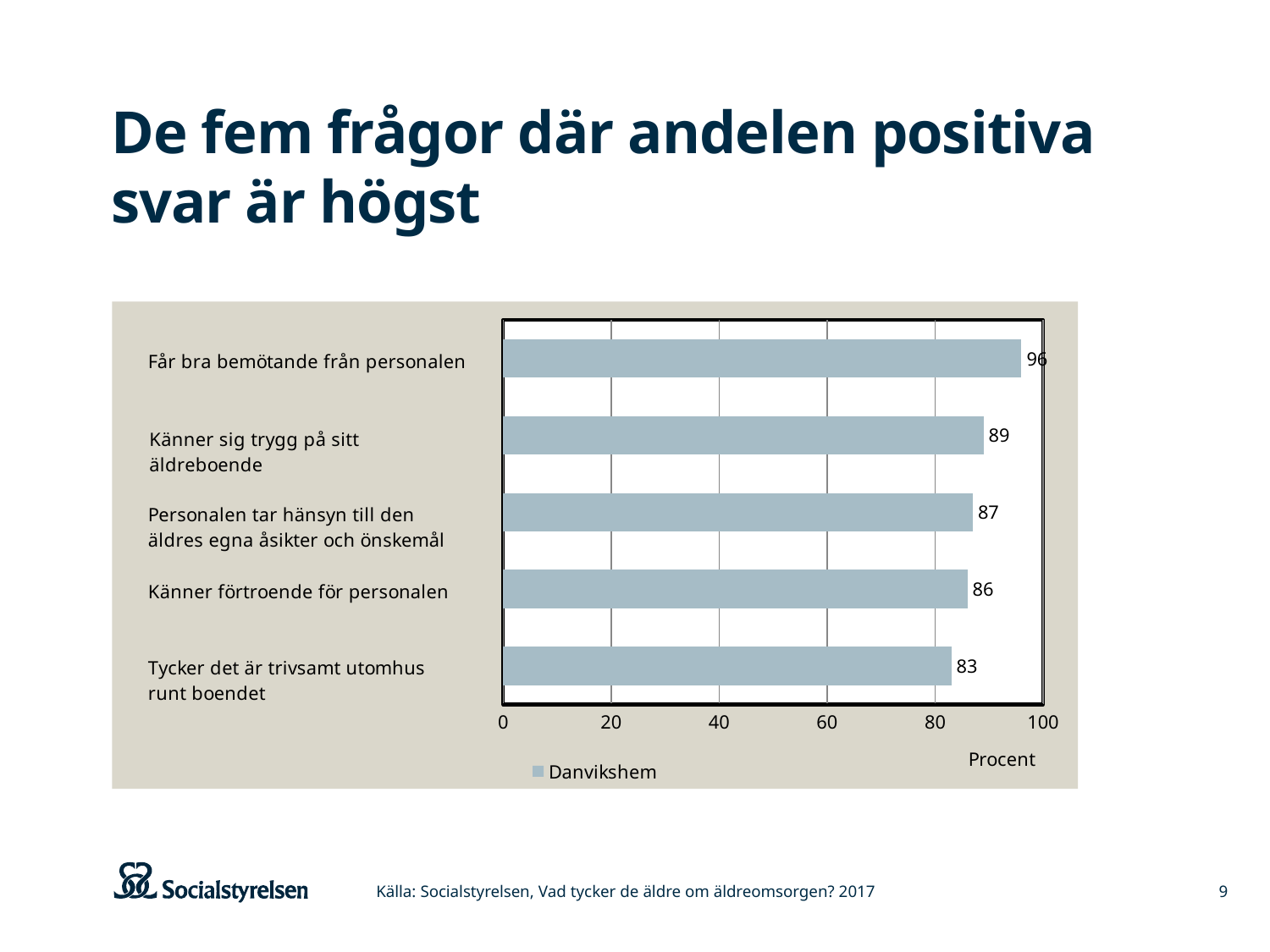
What kind of chart is shown on the slide? bar chart What is the value for "Känner förtroende för personalen"? 86 What is the value for "Får bra bemötande från personalen"? 96 What series name does the legend show? Danvikshem What is the value for "Känner sig trygg på sitt äldreboende"? 89 Is the value for "Känner sig trygg på sitt äldreboende" greater or less than 80? greater Which is larger: the value for "Personalen tar hänsyn till den äldres egna åsikter och önskemål" or the value for "Känner förtroende för personalen"? Personalen tar hänsyn till den äldres egna åsikter och önskemål Which category has the lowest value? Tycker det är trivsamt utomhus runt boendet What is the value for "Tycker det är trivsamt utomhus runt boendet"? 83 How many categories are shown in the chart? 5 Which category has the highest value? Får bra bemötande från personalen What is the difference between the values for "Får bra bemötande från personalen" and "Tycker det är trivsamt utomhus runt boendet"? 13